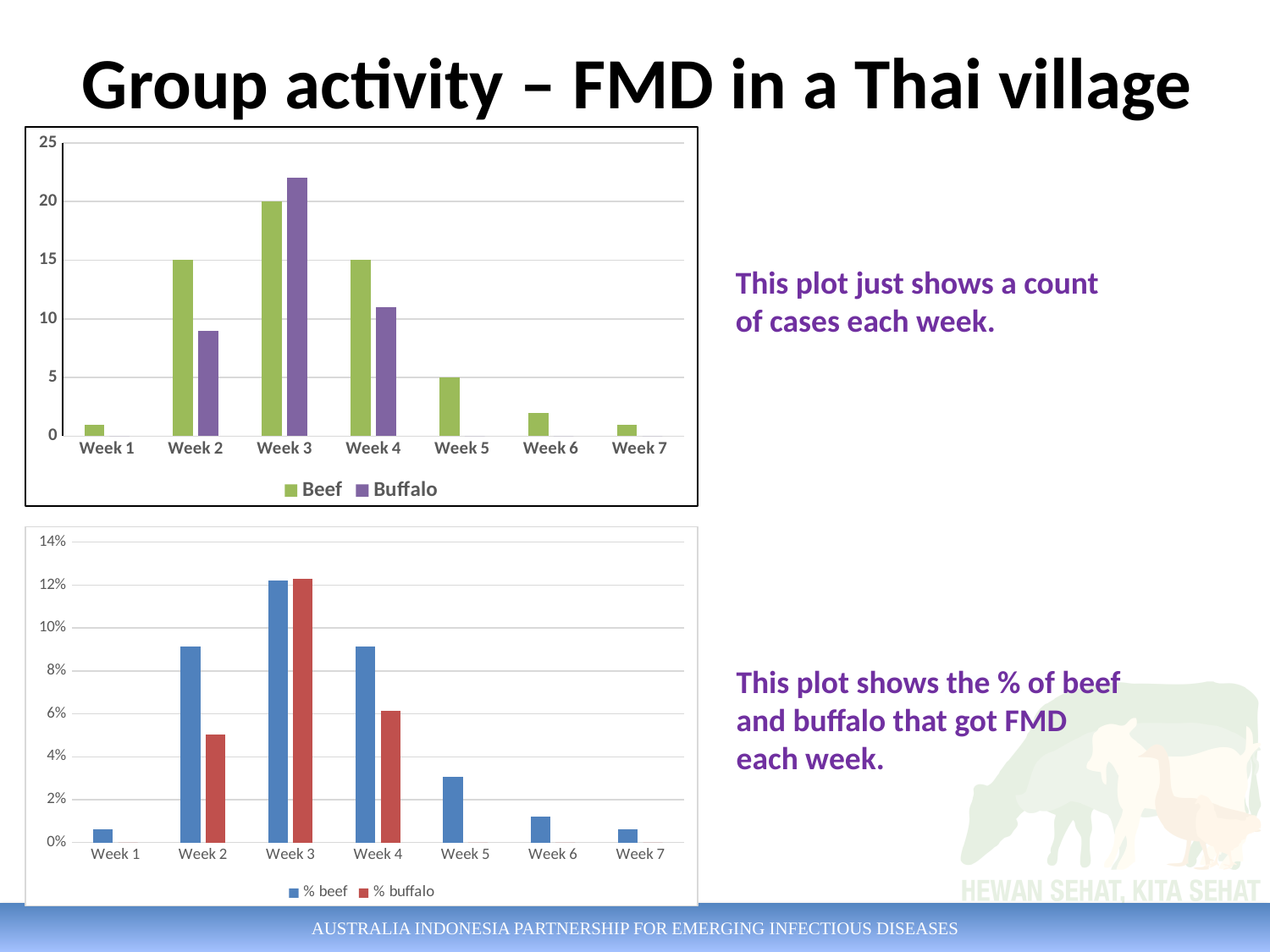
In the bottom chart, which is larger for Week 4: % beef or % buffalo? % beef In the top chart, what is the Beef count for Week 2? 15 In the top chart, is the Buffalo value for Week 3 greater or less than 20? greater In the top chart, what is the Beef count for Week 3? 20 In the top chart, which week has the highest Beef count? Week 3 How many series does the legend of the top chart list? 2 How many weeks are shown on the x axis of the top chart? 7 What are the two legend entries of the bottom chart? % beef and % buffalo In the top chart, what is the difference between the Beef count in Week 3 and the Beef count in Week 5? 15 In the top chart, which is larger for Week 2: Beef or Buffalo? Beef What kind of chart is the top chart on the slide? bar chart In the bottom chart, is the % beef value for Week 2 greater or less than 8%? greater